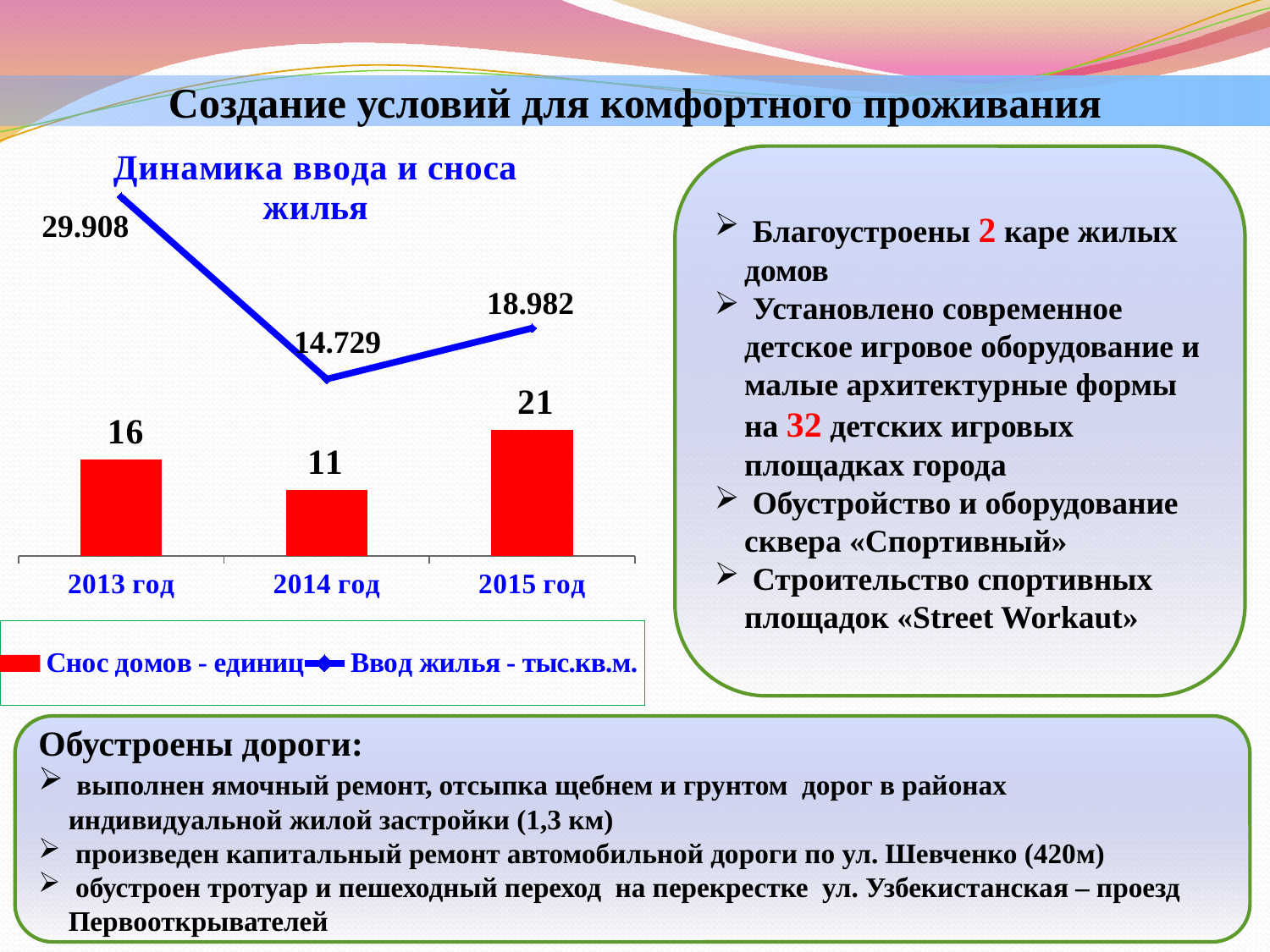
What is the difference between the 'Снос домов - единиц' values for 2015 год and 2013 год? 5 Which is larger: 'Ввод жилья - тыс.кв.м.' in 2013 год or in 2015 год? 2013 год What is the value of 'Ввод жилья - тыс.кв.м.' for 2015 год? 18.982 What is the value of 'Ввод жилья - тыс.кв.м.' for 2013 год? 29.908 What is the value of 'Снос домов - единиц' for 2014 год? 11 Which year has the lowest value for 'Ввод жилья - тыс.кв.м.'? 2014 год How many series does the chart legend list? 2 How many years are shown on the x axis of the chart? 3 How does 'Ввод жилья - тыс.кв.м.' change from 2013 год to 2014 год? It falls What is the title of the chart? Динамика ввода и сноса жилья What kind of chart is used for the 'Снос домов - единиц' series? Bar chart Which year has the highest value for 'Снос домов - единиц'? 2015 год